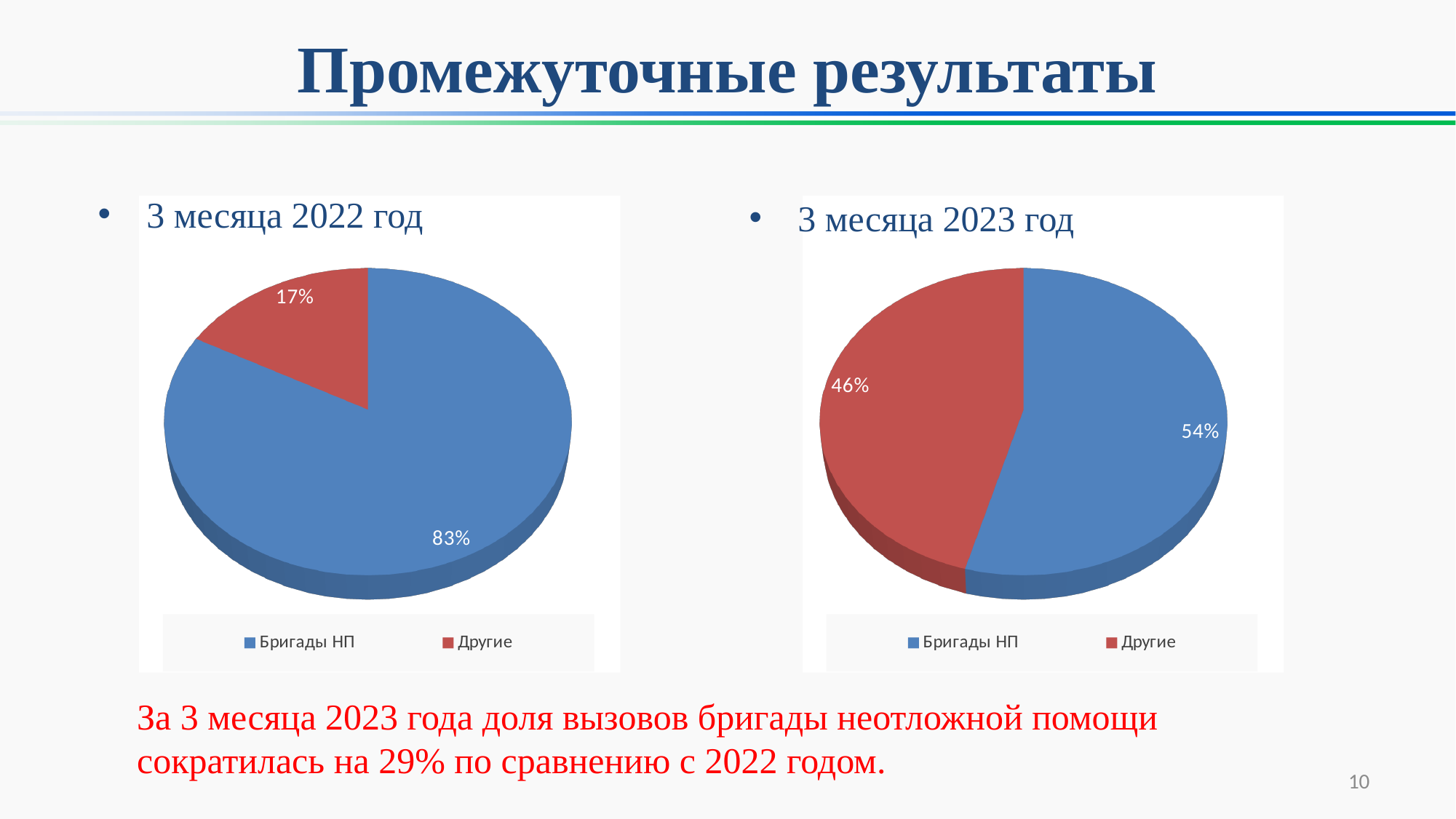
In the '3 месяца 2023 год' chart, what is the difference between the 'Бригады НП' and 'Другие' shares? 8% In the '3 месяца 2022 год' chart, which category has the largest slice? Бригады НП In the '3 месяца 2023 год' chart, what colour is the 'Другие' slice? Red How many slices does the '3 месяца 2023 год' chart have? 2 In the '3 месяца 2022 год' chart, what is the difference between the 'Бригады НП' and 'Другие' shares? 66% Which chart shows a larger share for 'Другие', the '3 месяца 2022 год' chart or the '3 месяца 2023 год' chart? 3 месяца 2023 год In the '3 месяца 2022 год' chart, what share does 'Бригады НП' have? 83% In the '3 месяца 2023 год' chart, what share does 'Бригады НП' have? 54% In the '3 месяца 2023 год' chart, what share does 'Другие' have? 46% In the '3 месяца 2022 год' chart, what share does 'Другие' have? 17% In the '3 месяца 2023 год' chart, which category has the smallest slice? Другие What type of chart is the '3 месяца 2022 год' chart? Pie chart